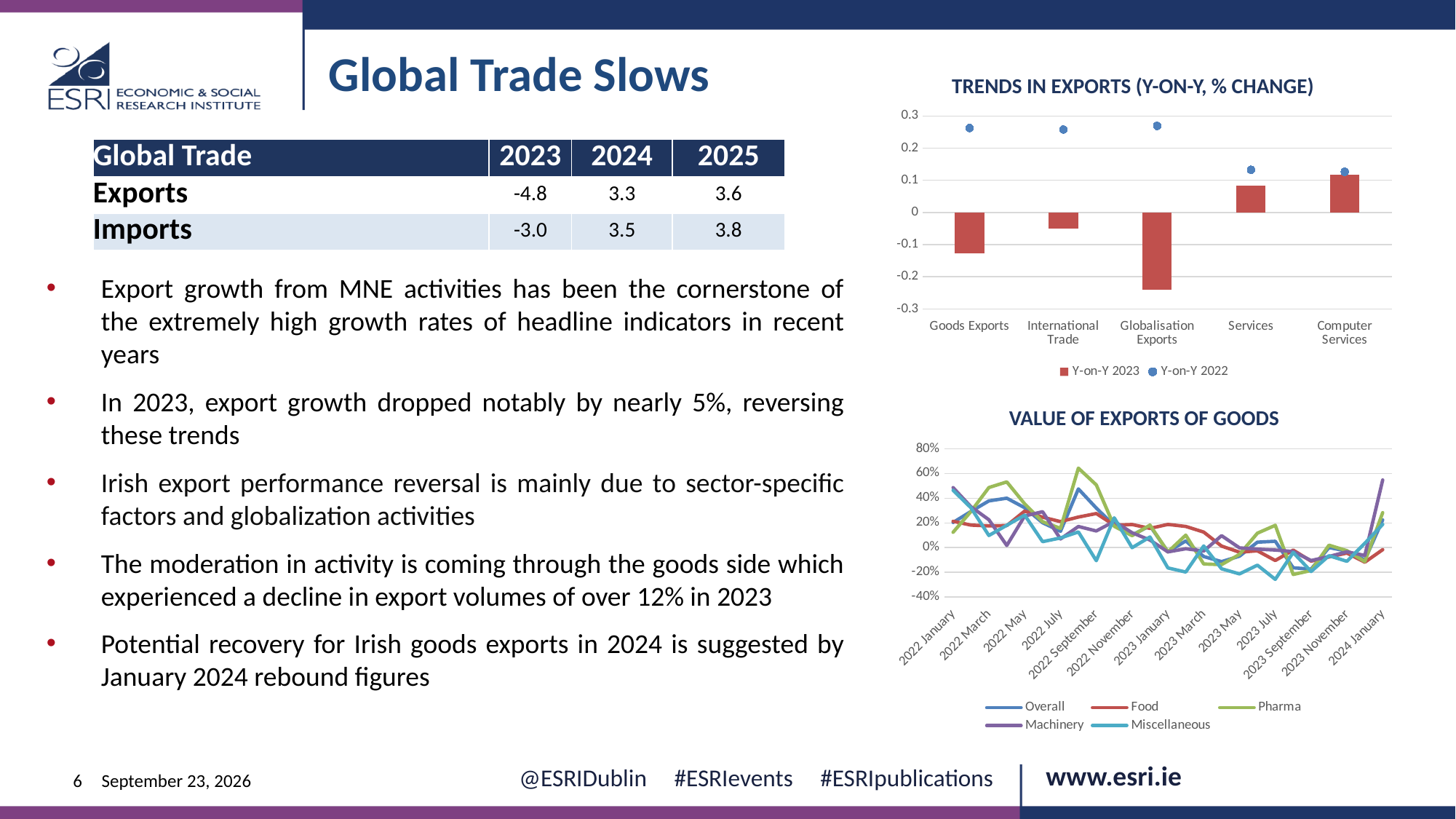
How many series does the legend of the 'VALUE OF EXPORTS OF GOODS' chart list? 5 In the 'TRENDS IN EXPORTS (Y-ON-Y, % CHANGE)' chart, is the Y-on-Y 2023 value for Globalisation Exports greater or less than -0.2? less In the 'VALUE OF EXPORTS OF GOODS' chart, is the Machinery value at 2024 January greater or less than 40%? greater In the 'TRENDS IN EXPORTS (Y-ON-Y, % CHANGE)' chart, is the Y-on-Y 2023 value for Goods Exports greater or less than -0.1? less How many series does the legend of the 'TRENDS IN EXPORTS (Y-ON-Y, % CHANGE)' chart list? 2 In the 'TRENDS IN EXPORTS (Y-ON-Y, % CHANGE)' chart, which category has the lowest Y-on-Y 2023 value? Globalisation Exports In the 'TRENDS IN EXPORTS (Y-ON-Y, % CHANGE)' chart, which category has the highest Y-on-Y 2023 value? Computer Services In the 'VALUE OF EXPORTS OF GOODS' chart, which series has the highest value at 2024 January? Machinery How many categories are shown on the x axis of the 'TRENDS IN EXPORTS (Y-ON-Y, % CHANGE)' chart? 5 What type of chart is 'VALUE OF EXPORTS OF GOODS'? line chart In the 'TRENDS IN EXPORTS (Y-ON-Y, % CHANGE)' chart, which is larger for Services: the Y-on-Y 2023 value or the Y-on-Y 2022 value? Y-on-Y 2022